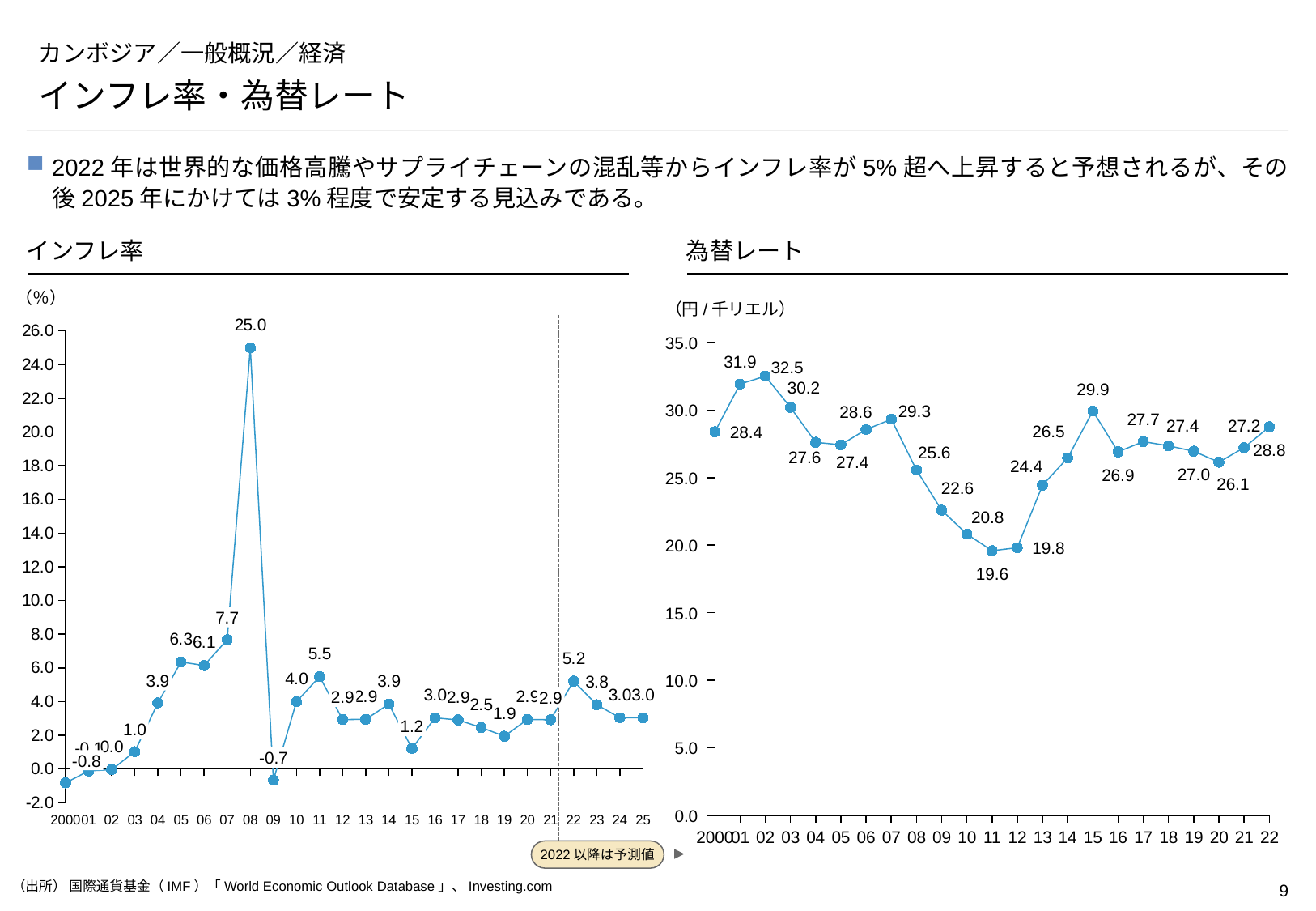
In the インフレ率 chart, which year has the highest inflation rate? 2008 In the インフレ率 chart, which is larger, the value for 2005 or the value for 2006? 2005 In the 為替レート chart, which year has the lowest value? 2011 In the インフレ率 chart, what is the inflation rate value for 2008? 25.0 What kind of chart is the インフレ率 chart? line chart In the インフレ率 chart, what is the difference between the 2022 value and the 2023 value? 1.4 In the 為替レート chart, which year has the highest value? 2002 In the 為替レート chart, do the values rise or fall from 2008 to 2011? fall In the 為替レート chart, what is the difference between the 2002 value and the 2011 value? 12.9 In the 為替レート chart, how many years are plotted? 23 In the 為替レート chart, what is the value for 2015? 29.9 In the インフレ率 chart, what is the value for 2022? 5.2